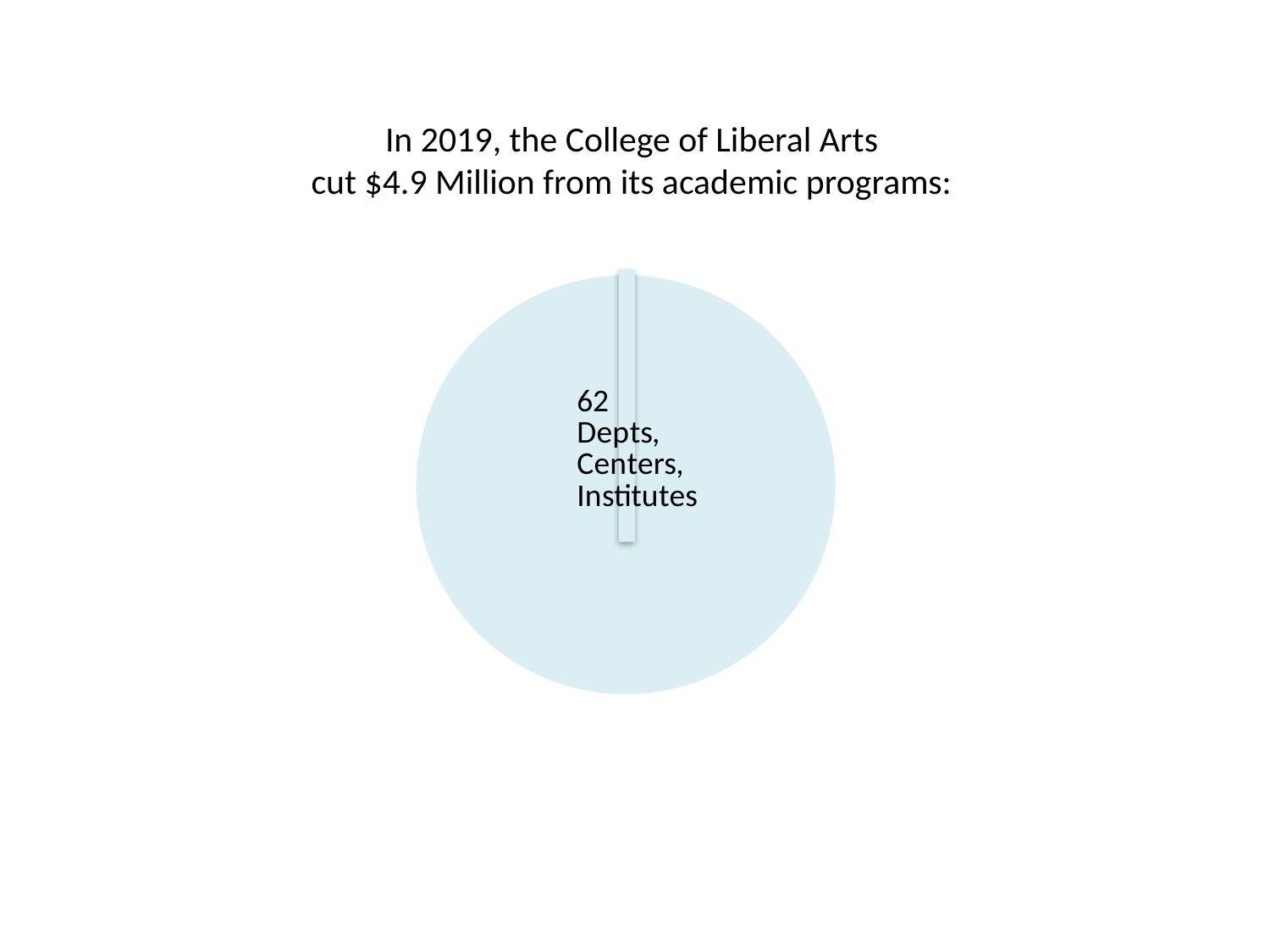
According to the text above the chart, how much did the College of Liberal Arts cut from its academic programs in 2019? $4.9 Million How many slices does the pie chart have? 1 What is the label on the pie chart's slice? 62 Depts, Centers, Institutes How many departments, centers and institutes does the pie chart's label mention? 62 What share of the pie does the slice labeled '62 Depts, Centers, Institutes' take up? 100% Which year does the text above the chart refer to? 2019 What kind of chart is shown on the slide? pie chart